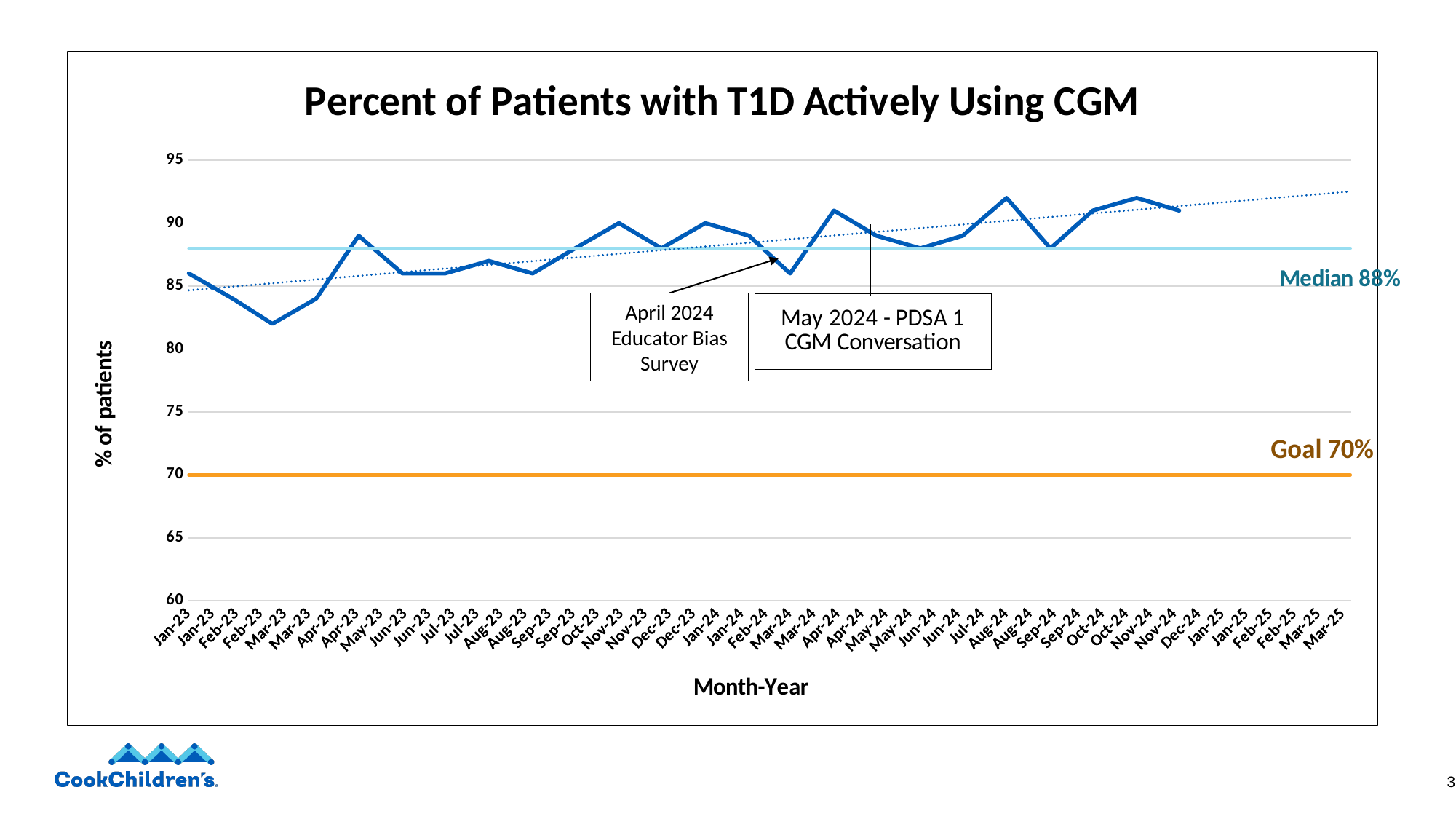
Does the plotted line ever fall below the Goal 70% line? No Is the value plotted around Aug-24 greater or less than 90? greater Is the Median 88% line above or below the Goal 70% line? Above What is the label of the vertical axis? % of patients What is the title of the chart? Percent of Patients with T1D Actively Using CGM What is the difference between the median value and the goal value shown on the chart? 18% Is the lowest point of the plotted line (around Mar-23) greater or less than 85? less What median value is labelled on the chart? Median 88% What kind of chart is shown on the slide? Line chart Which is larger, the value plotted around Mar-23 or the value plotted around Aug-24? Aug-24 Does the dotted trend line rise or fall from left to right? Rises What goal value is labelled on the chart? Goal 70%